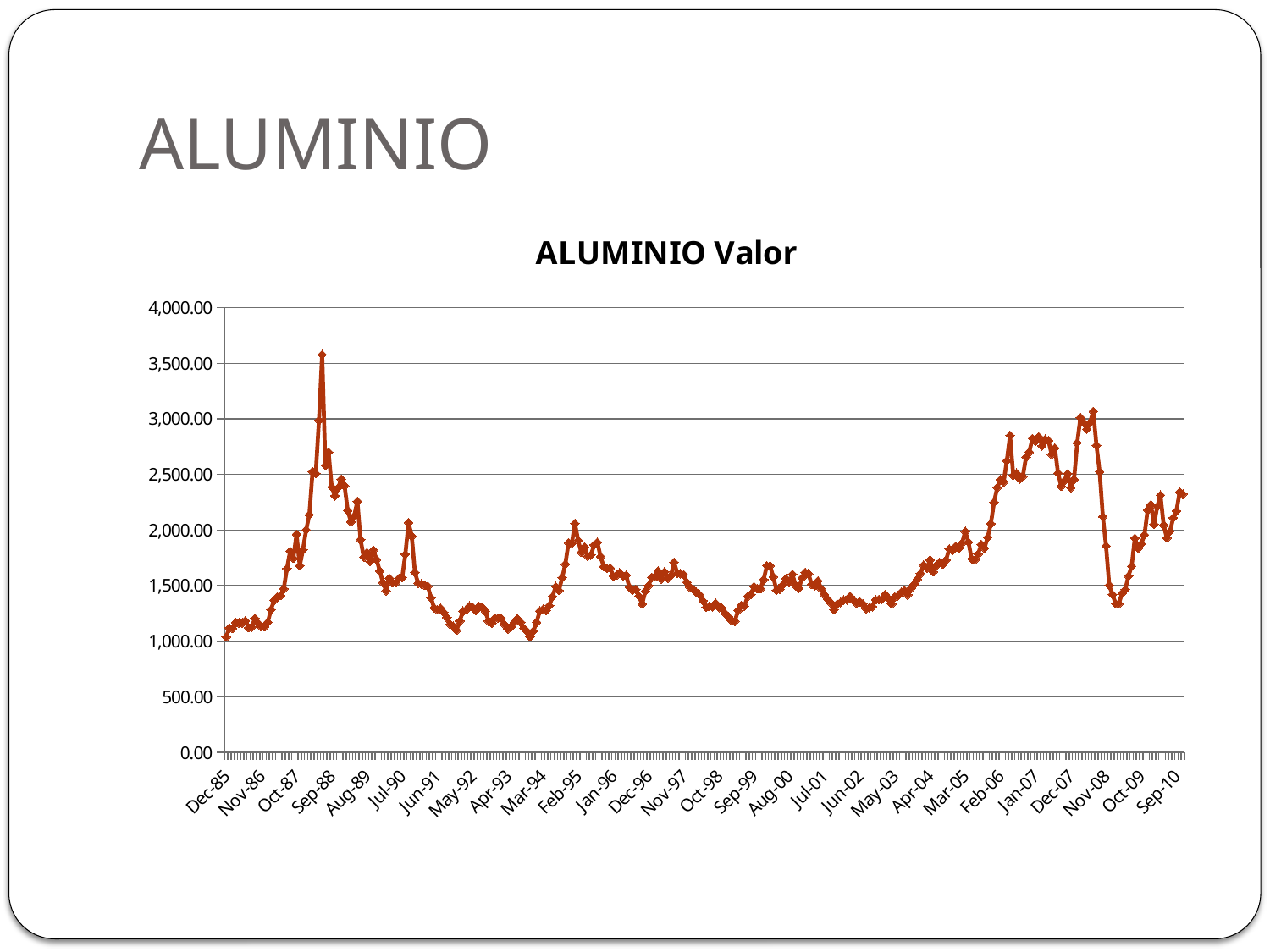
What is the highest value shown on the vertical axis of the chart? 4,000.00 Is the value at Jan-07 greater or less than 2,500? greater Near which x-axis label does the line reach its highest value? Sep-88 Does the line rise or fall between Sep-88 and Aug-89? fall Is the value at Sep-10 greater or less than 2,000? greater Is the peak value near Sep-88 greater or less than 3,000? greater What kind of chart is shown on the slide? line chart Which is higher: the peak near Sep-88 or the peak near Nov-08? the peak near Sep-88 What is the title of the chart? ALUMINIO Valor